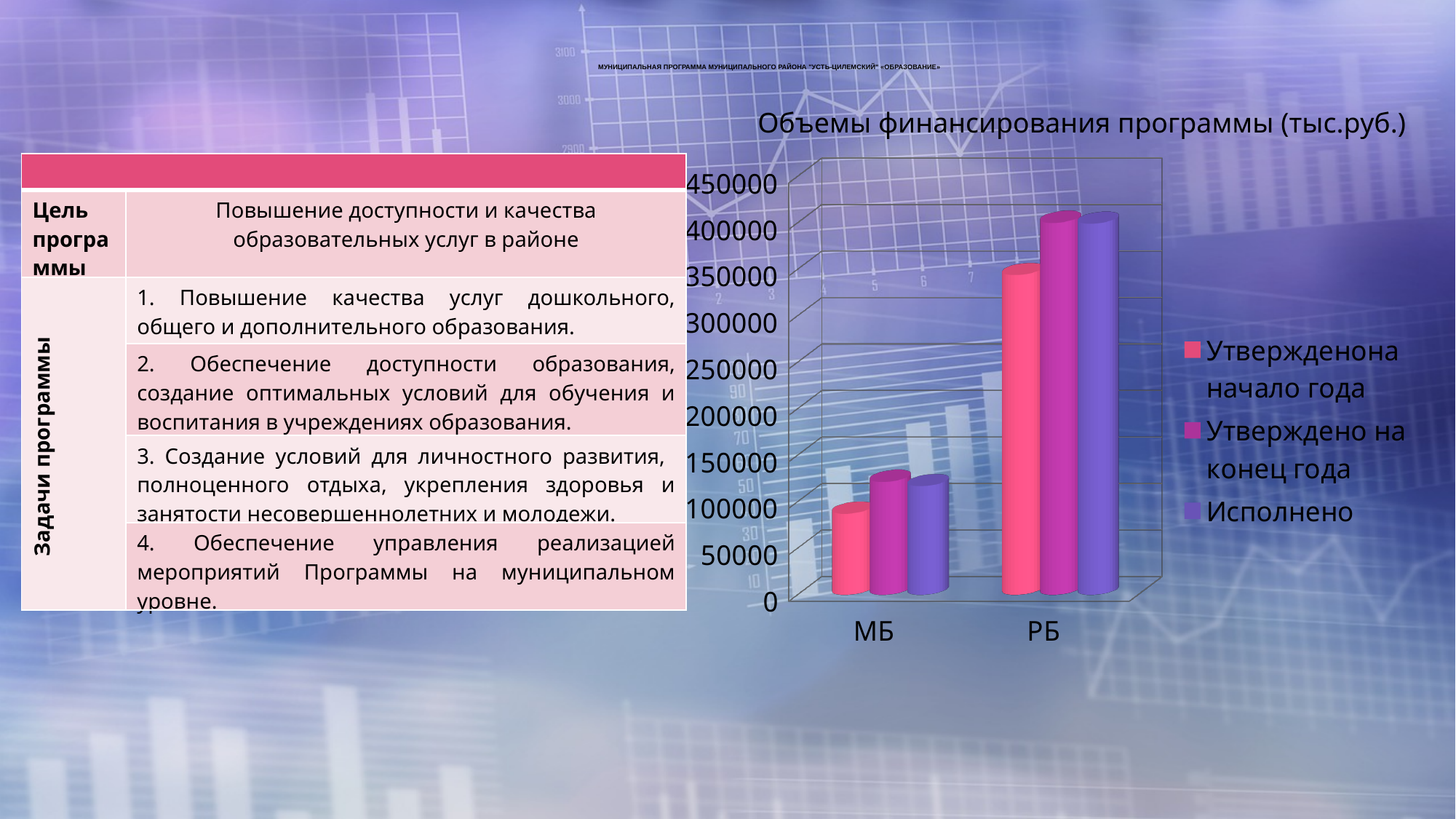
What is the title of the chart? Объемы финансирования программы (тыс.руб.) For the category МБ, which series has the lowest value? Утвержденона начало года For the category РБ, which series has the lowest value? Утвержденона начало года Is the value of 'Исполнено' for МБ greater or less than 200000? less Which category has the higher values in the chart, МБ or РБ? РБ Which series is shown in purple in the chart legend? Исполнено What kind of chart is shown on the slide? bar chart Is the value of 'Утвержденона начало года' for РБ greater or less than 300000? greater Is the value of 'Утверждено на конец года' for РБ greater or less than 350000? greater How many series does the chart legend list? 3 How many categories are shown on the x axis of the chart? 2